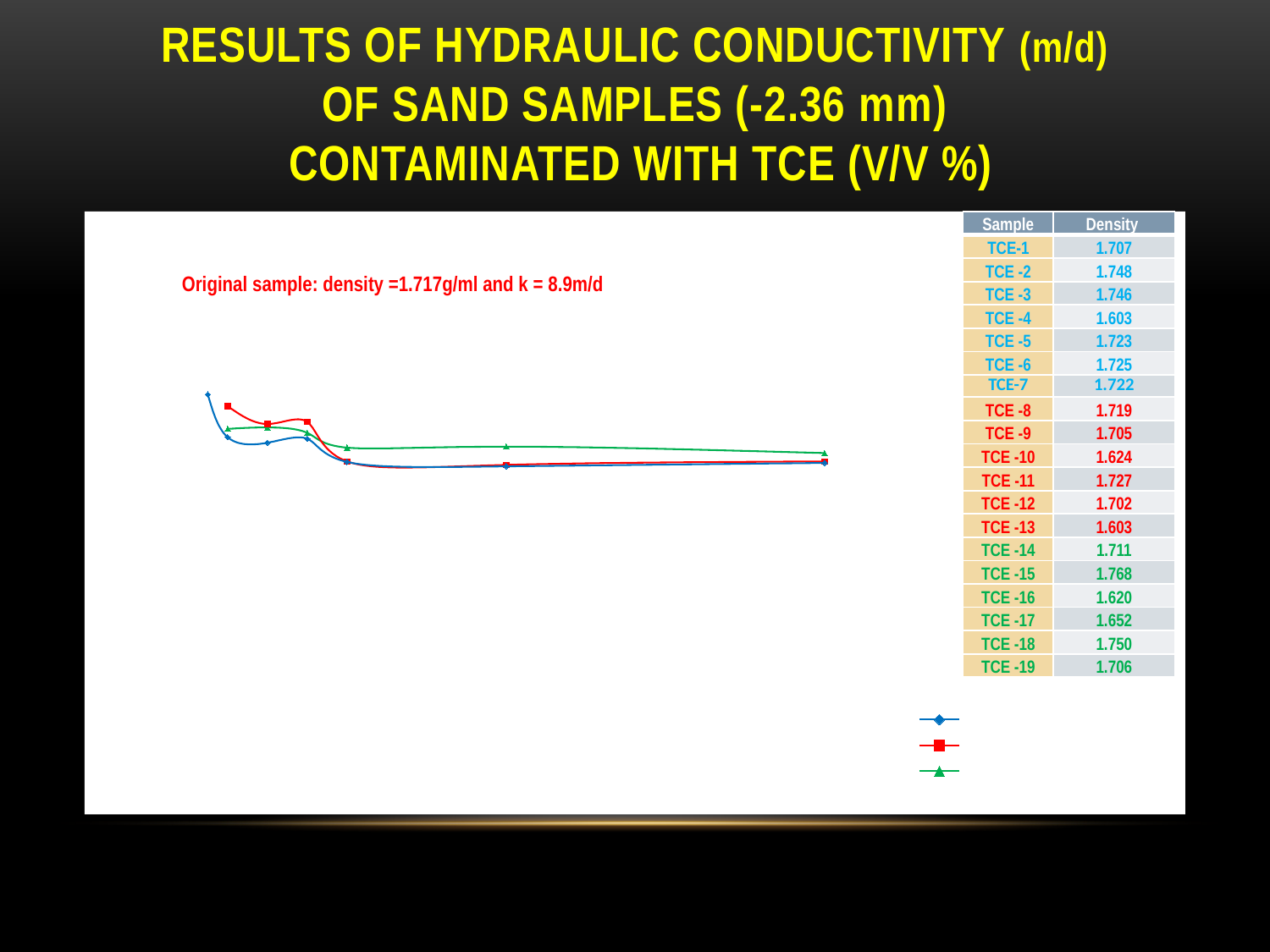
How many series does the chart's legend list? 3 What kind of chart is shown on the slide? line chart At the rightmost point of the chart, which series is higher: the green triangle series or the blue diamond series? green triangle series Which series is plotted with square markers? the red series What marker shape is used for the green series? triangle Do the plotted values generally rise or fall from left to right along the x axis? fall